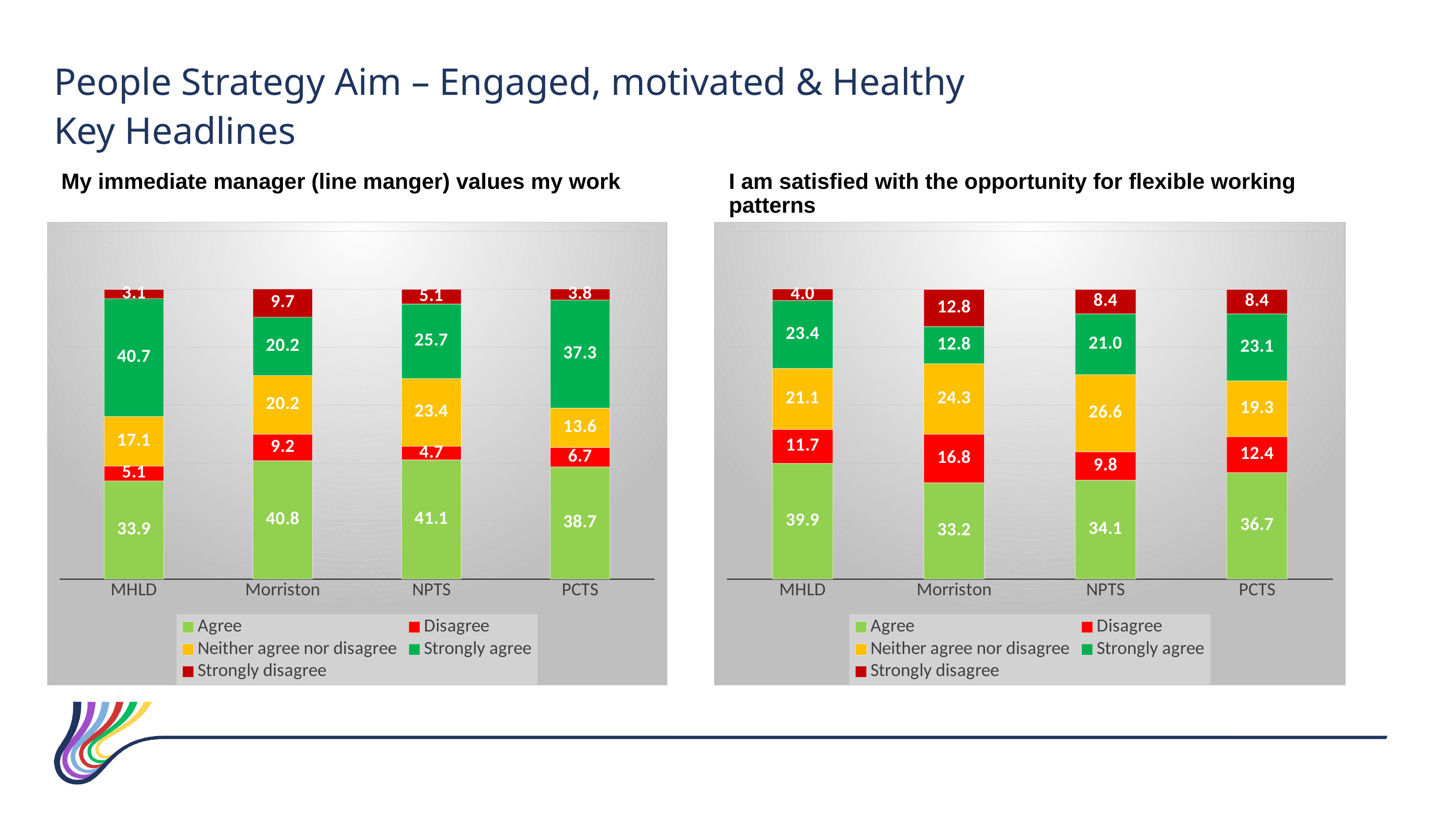
In the chart 'I am satisfied with the opportunity for flexible working patterns', what is the difference between the Agree values for MHLD and Morriston? 6.7 In the chart 'My immediate manager (line manger) values my work', which category has the highest Strongly disagree value? Morriston What kind of chart is the left chart on the slide? Stacked bar chart How many categories are shown on the x axis of the chart 'My immediate manager (line manger) values my work'? 4 In the chart 'My immediate manager (line manger) values my work', what is the difference between the Strongly agree values for MHLD and Morriston? 20.5 In the chart 'I am satisfied with the opportunity for flexible working patterns', what is the Disagree value for Morriston? 16.8 In the chart 'I am satisfied with the opportunity for flexible working patterns', which is larger, the Disagree value for MHLD or for PCTS? PCTS How many series does the legend list in the chart 'I am satisfied with the opportunity for flexible working patterns'? 5 In the chart 'I am satisfied with the opportunity for flexible working patterns', which category has the lowest Strongly agree value? Morriston In the chart 'My immediate manager (line manger) values my work', what is the Strongly agree value for MHLD? 40.7 In the chart 'I am satisfied with the opportunity for flexible working patterns', what is the Neither agree nor disagree value for NPTS? 26.6 In the chart 'My immediate manager (line manger) values my work', what is the Agree value for NPTS? 41.1